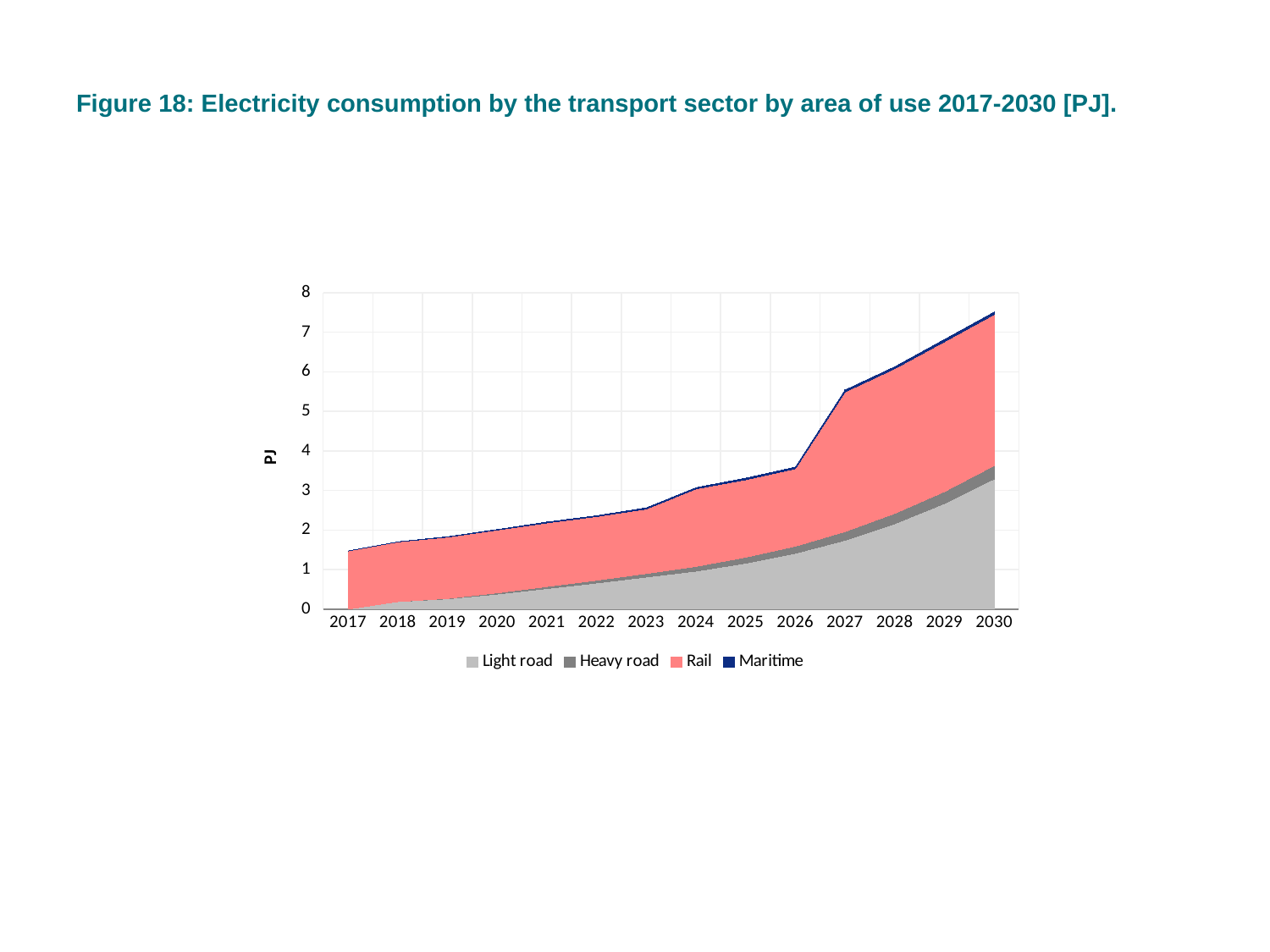
Does total electricity consumption by the transport sector rise or fall from 2017 to 2030? Rise Is the total electricity consumption in 2030 greater or less than 7 PJ? greater What unit is shown on the y axis? PJ In which year is total electricity consumption lowest? 2017 Is the total electricity consumption in 2027 greater or less than 5 PJ? greater Is the total electricity consumption in 2017 greater or less than 2 PJ? less How many years are shown along the x axis? 14 What kind of chart is shown on the slide? Stacked area chart How many series does the legend list? 4 Which series accounts for the largest share of consumption in 2027, Rail or Light road? Rail In which year is total electricity consumption highest? 2030